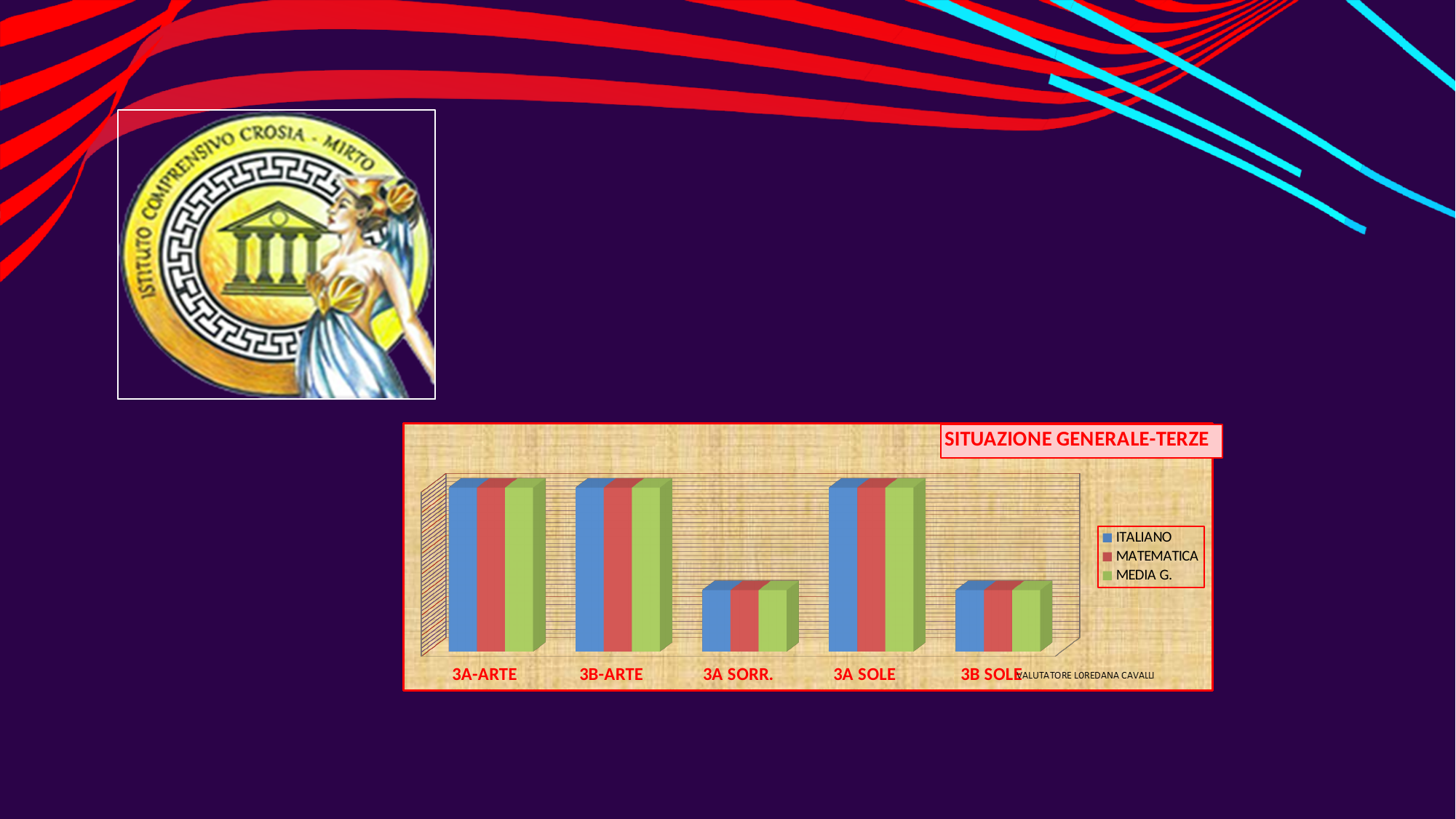
What kind of chart is shown on the slide? bar chart Which has the larger MEDIA G. value, 3A SOLE or 3A SORR.? 3A SOLE Is the ITALIANO value for 3A-ARTE larger or smaller than the ITALIANO value for 3A SORR.? larger How many categories are shown along the x axis of the chart? 5 Which series is shown in green in the chart? MEDIA G. Which has the larger MEDIA G. value, 3B-ARTE or 3B SOLE? 3B-ARTE How many series does the chart's legend list? 3 What is the title of the chart? SITUAZIONE GENERALE-TERZE